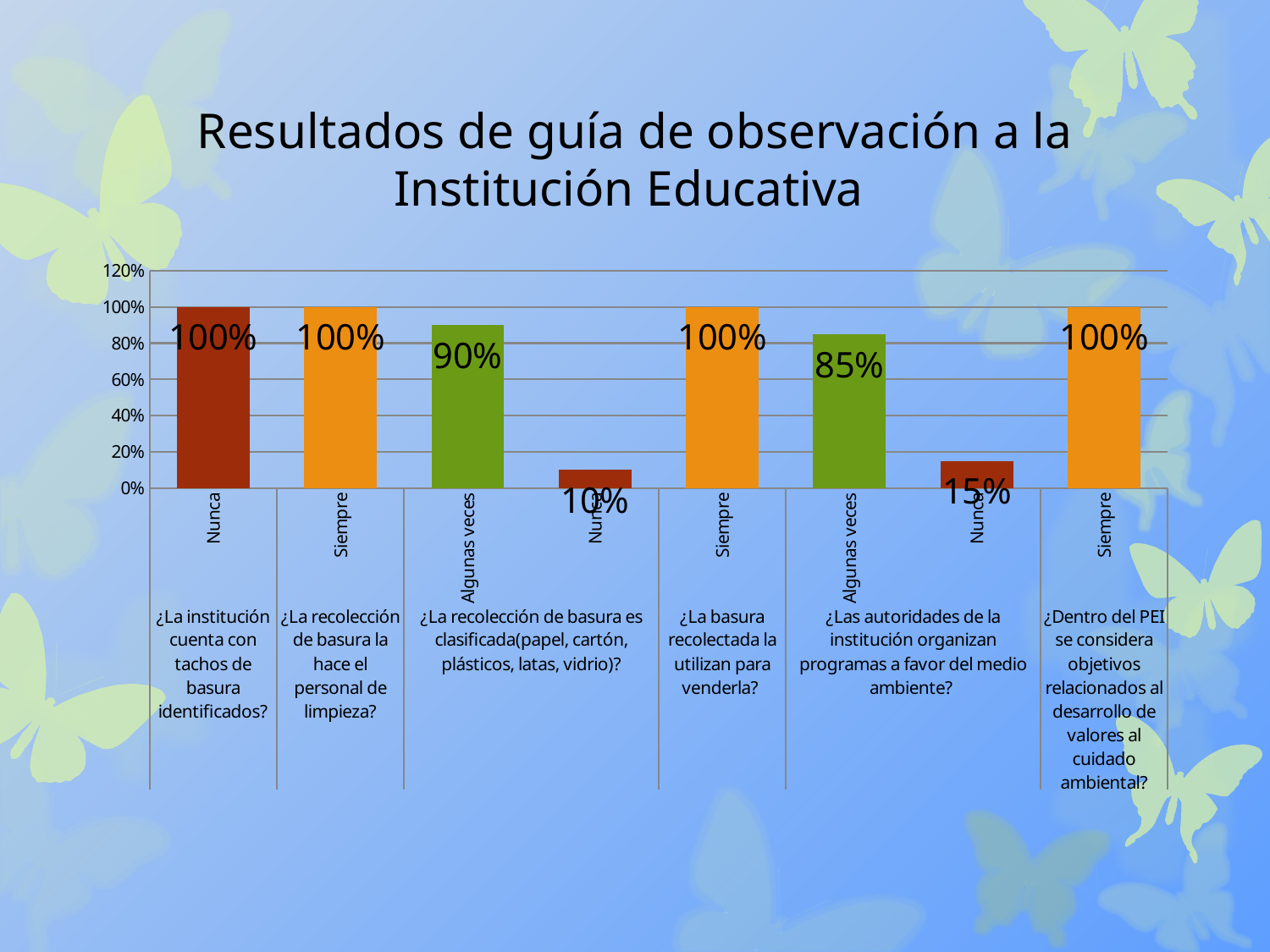
What is the value of the 'Algunas veces' bar for '¿La recolección de basura es clasificada(papel, cartón, plásticos, latas, vidrio)?' 90% What is the title of the slide? Resultados de guía de observación a la Institución Educativa What is the difference between the 'Algunas veces' and 'Nunca' bars for '¿Las autoridades de la institución organizan programas a favor del medio ambiente?' 70% Which is larger: the 'Algunas veces' bar for the garbage classification question (90%) or the 'Algunas veces' bar for the environmental programs question (85%)? The garbage classification question (90%) What is the value of the 'Nunca' bar for '¿Las autoridades de la institución organizan programas a favor del medio ambiente?' 15% How many bars are plotted in the chart? 8 What is the value of the 'Nunca' bar for '¿La institución cuenta con tachos de basura identificados?' 100% What is the value of the 'Algunas veces' bar for '¿Las autoridades de la institución organizan programas a favor del medio ambiente?' 85% What kind of chart is shown on the slide? Bar chart Which bar has the lowest value in the chart? Nunca (¿La recolección de basura es clasificada?), 10% What is the difference between the 'Algunas veces' and 'Nunca' bars for '¿La recolección de basura es clasificada(papel, cartón, plásticos, latas, vidrio)?' 80% What is the value of the 'Nunca' bar for '¿La recolección de basura es clasificada(papel, cartón, plásticos, latas, vidrio)?' 10%